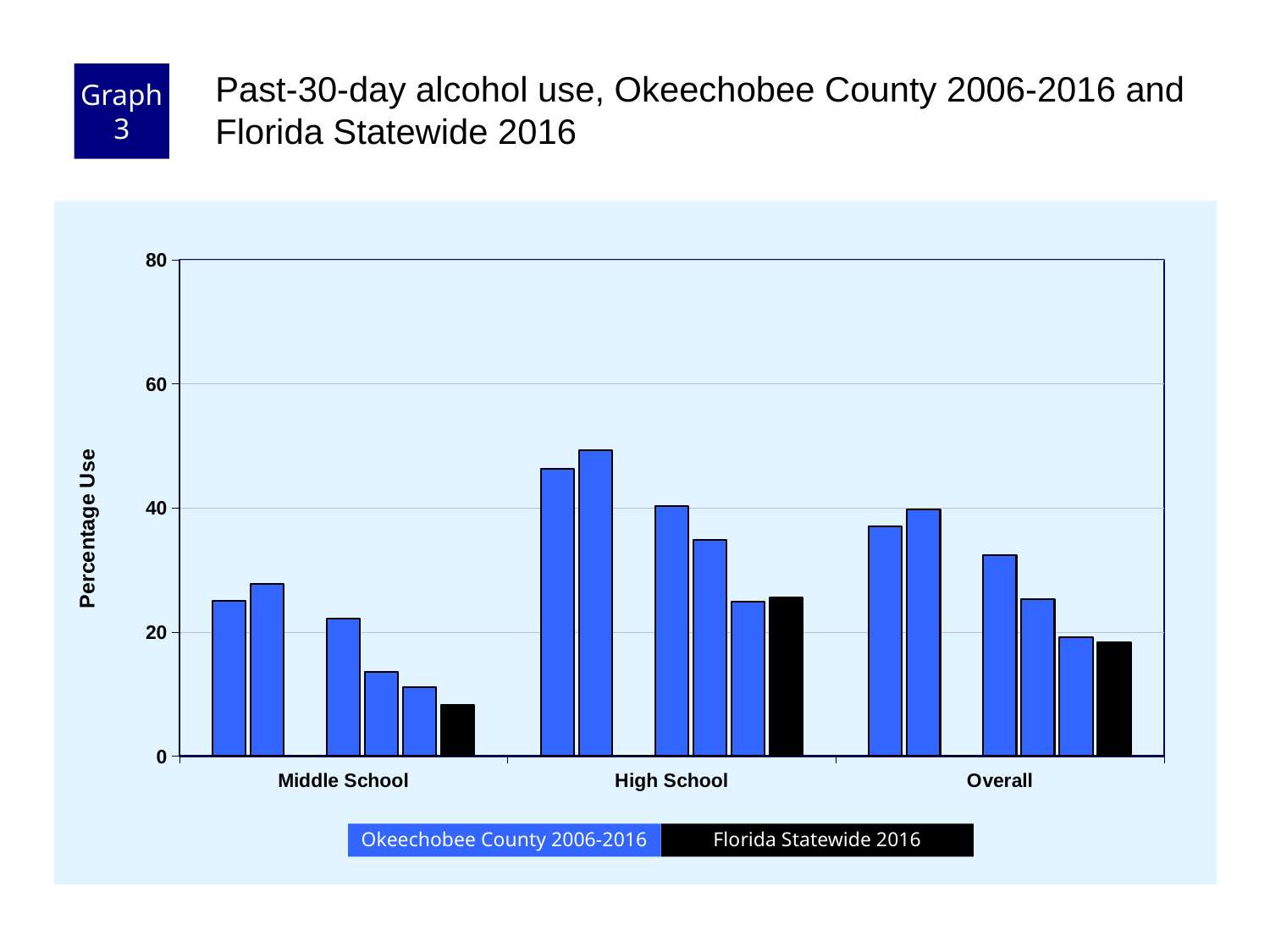
Which series is shown in black in the legend? Florida Statewide 2016 Which category has the highest Florida Statewide 2016 bar? High School What kind of chart is shown on the slide? bar chart In the Overall group, is the first Okeechobee County bar or the last Okeechobee County bar taller? the first Is the Florida Statewide 2016 value for High School greater or less than 40? less Is the tallest Okeechobee County bar in the High School group greater or less than 40? greater What is the title of the y axis? Percentage Use Which category has the lowest Florida Statewide 2016 bar? Middle School How many series does the legend list? 2 Is the Florida Statewide 2016 value for High School greater or less than 20? greater How many school-level categories are shown on the x axis? 3